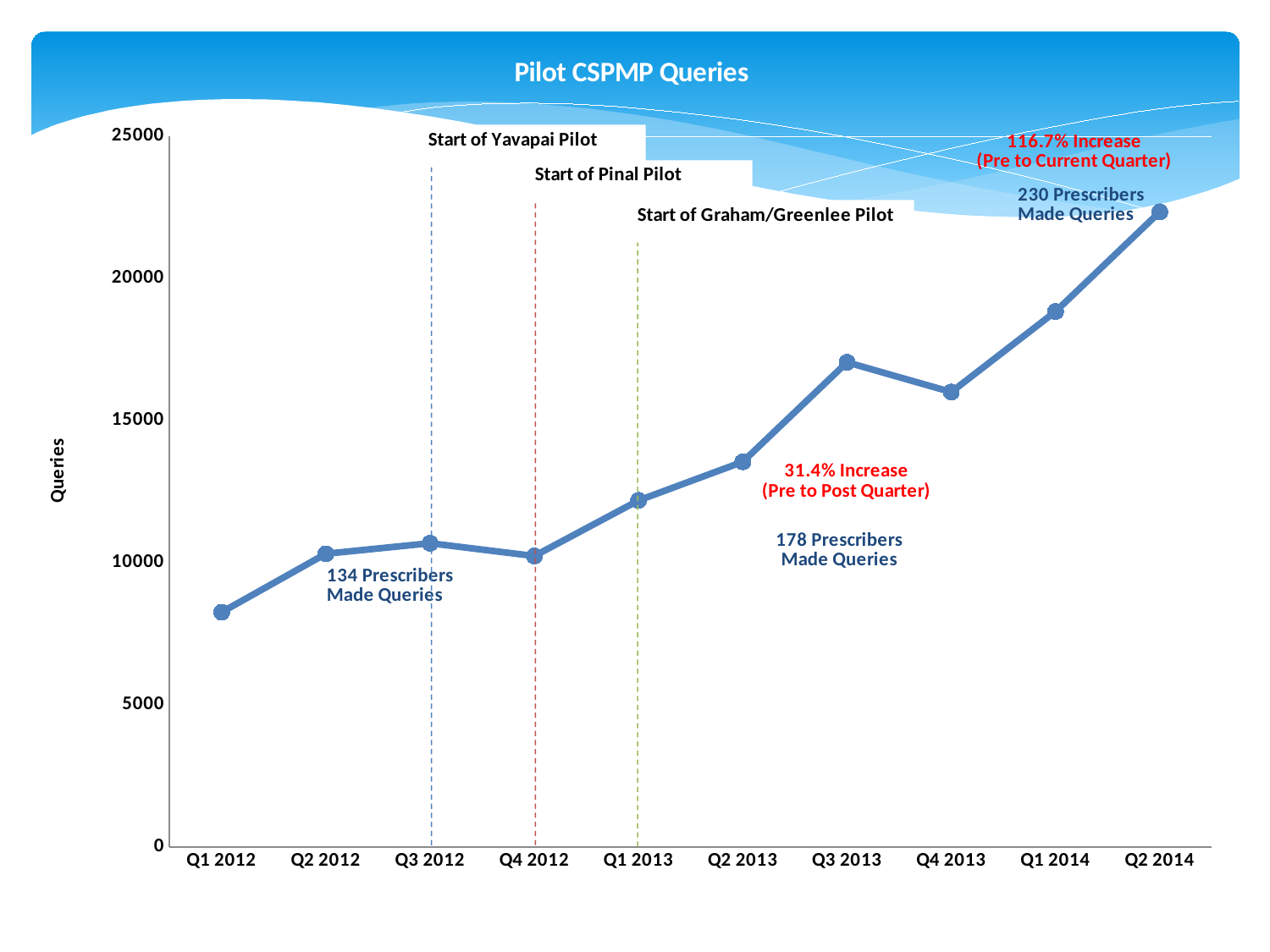
Is the value for Q1 2012 greater or less than 10000? less What kind of chart is shown on the slide? line chart What percentage increase is annotated for pre to current quarter? 116.7% How many quarters are plotted on the x axis? 10 Which quarter has the highest number of queries? Q2 2014 Which quarter has the lowest number of queries? Q1 2012 Is the value for Q2 2014 greater or less than 20000? greater Is the value for Q3 2013 greater or less than 15000? greater Which quarter has more queries, Q3 2013 or Q4 2013? Q3 2013 Do the query counts generally rise or fall from Q1 2012 to Q2 2014? rise What is the title of the chart? Pilot CSPMP Queries